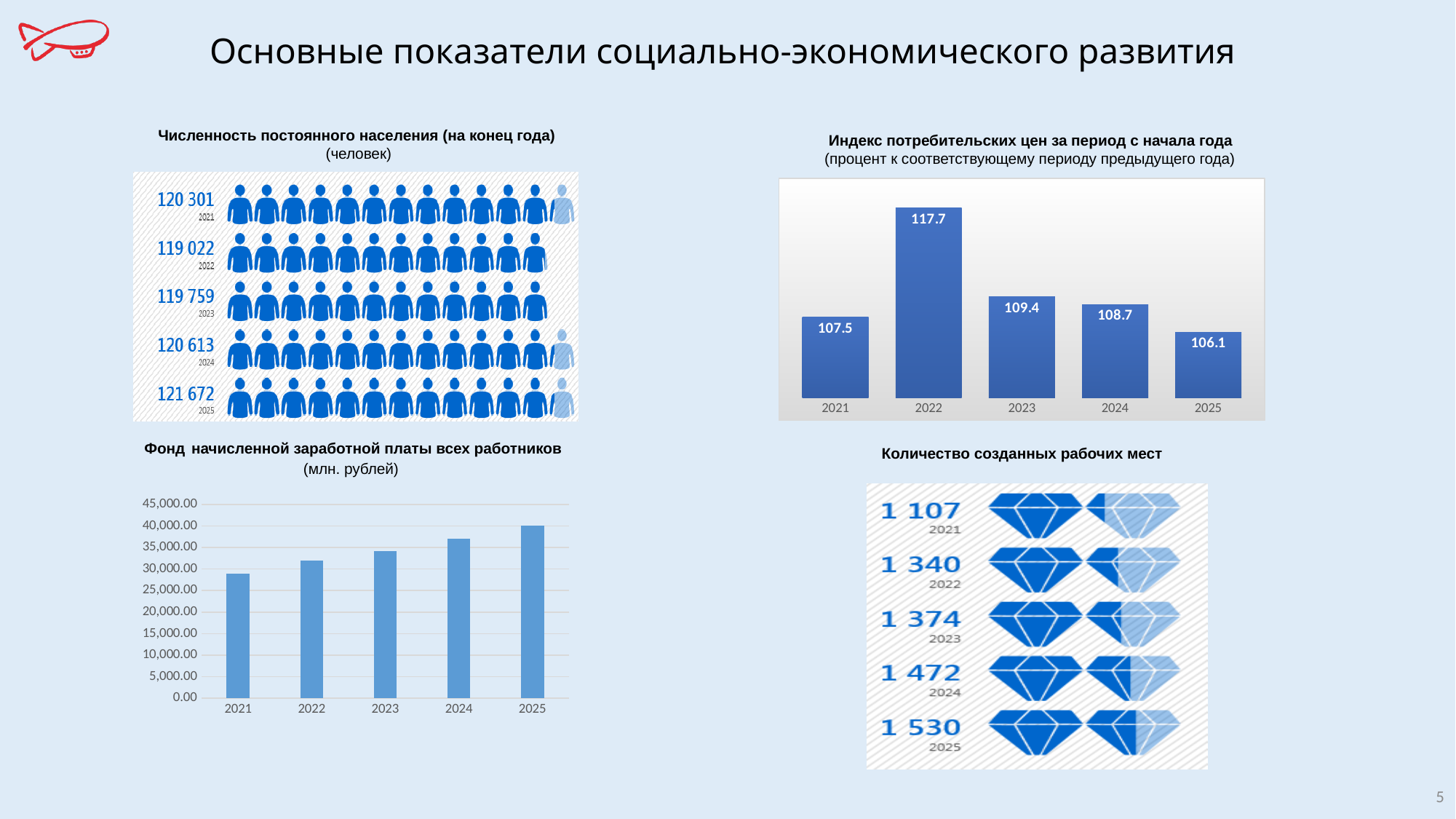
In the chart "Индекс потребительских цен за период с начала года", how many bars are plotted? 5 In the chart "Количество созданных рабочих мест", what is the difference between the 2025 and 2021 values? 423 In the chart "Индекс потребительских цен за период с начала года", which year has the lowest value? 2025 In the chart "Численность постоянного населения (на конец года)", what is the population for 2023? 119 759 In the chart "Индекс потребительских цен за период с начала года", what is the difference between the 2022 and 2021 values? 10.2 In the chart "Фонд начисленной заработной платы всех работников", do the values rise or fall from 2021 to 2025? rise In the chart "Количество созданных рабочих мест", what is the value for 2024? 1 472 In the chart "Индекс потребительских цен за период с начала года", what is the value for 2022? 117.7 In the chart "Фонд начисленной заработной платы всех работников", is the value for 2025 greater or less than 35,000.00? greater In the chart "Численность постоянного населения (на конец года)", which year has the lowest population? 2022 In the chart "Фонд начисленной заработной платы всех работников", is the value for 2021 greater or less than 30,000.00? less In the chart "Численность постоянного населения (на конец года)", which is larger, the value for 2021 or the value for 2024? 2024